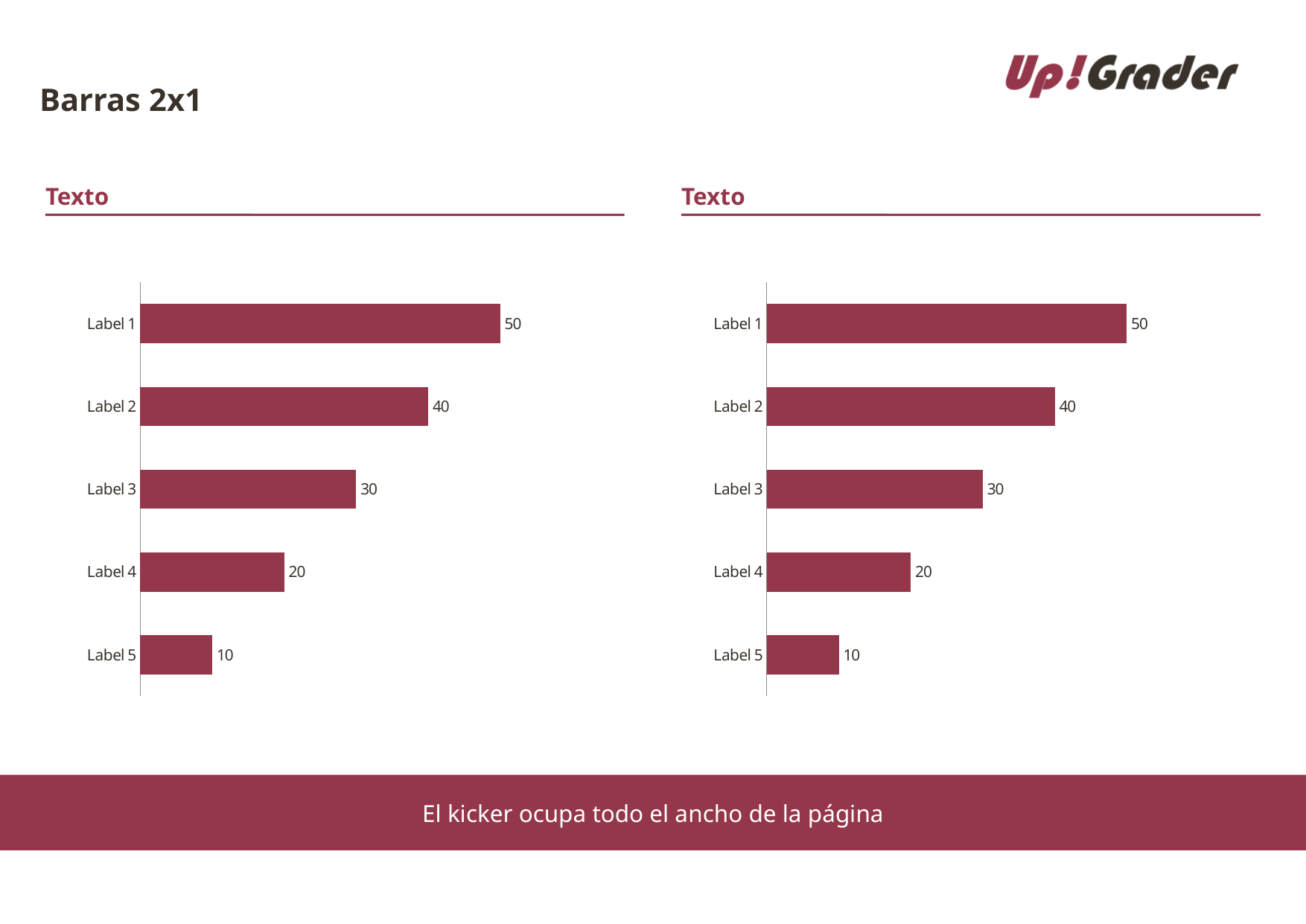
In the right chart, what is the difference between the values for Label 2 and Label 3? 10 In the right chart, what is the value for Label 4? 20 How many charts are shown on the slide? 2 What kind of chart is the right chart? Bar chart In the right chart, which category has the highest value? Label 1 In the left chart, do the values rise or fall from Label 1 to Label 5? Fall How many categories does the left chart show? 5 In the left chart, which category has the lowest value? Label 5 In the right chart, which is larger, the value for Label 2 or the value for Label 4? Label 2 In the left chart, what is the value for Label 1? 50 In the left chart, what is the difference between the values for Label 1 and Label 5? 40 In the left chart, what is the value for Label 3? 30